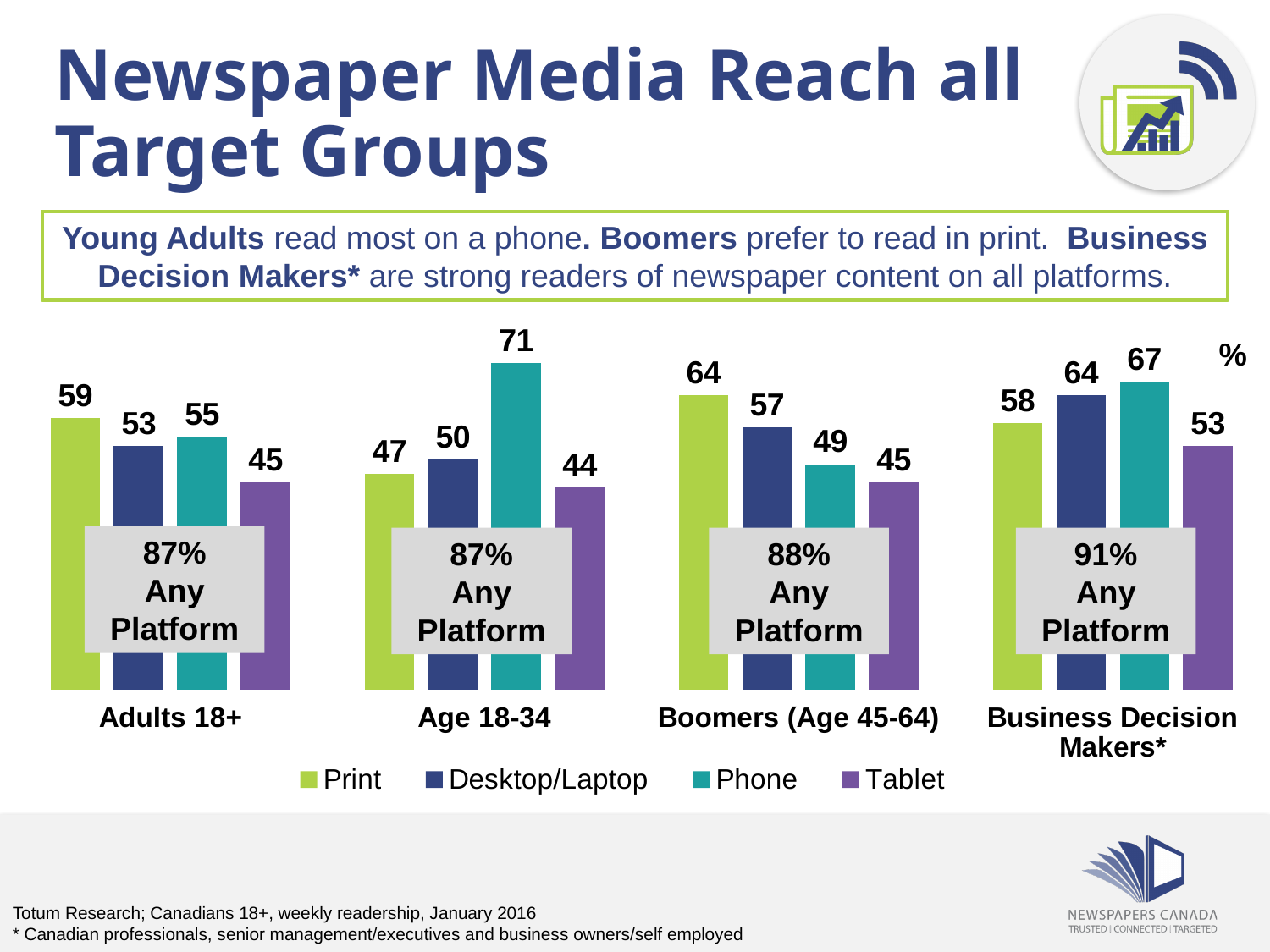
Which platform has the lowest value for Age 18-34? Tablet Which legend entry is shown in green? Print What is the 'Any Platform' percentage shown for Business Decision Makers*? 91% What is the Print value for Boomers (Age 45-64)? 64 How many target groups are shown on the x axis? 4 Which platform has the highest value for Adults 18+? Print What is the difference between the Phone and Print values for Age 18-34? 24 Which is larger for Boomers (Age 45-64): the Desktop/Laptop value or the Phone value? Desktop/Laptop What is the Tablet value for Business Decision Makers*? 53 What is the Phone value for Age 18-34? 71 What kind of chart is shown on the slide? Bar chart How many series does the legend list? 4